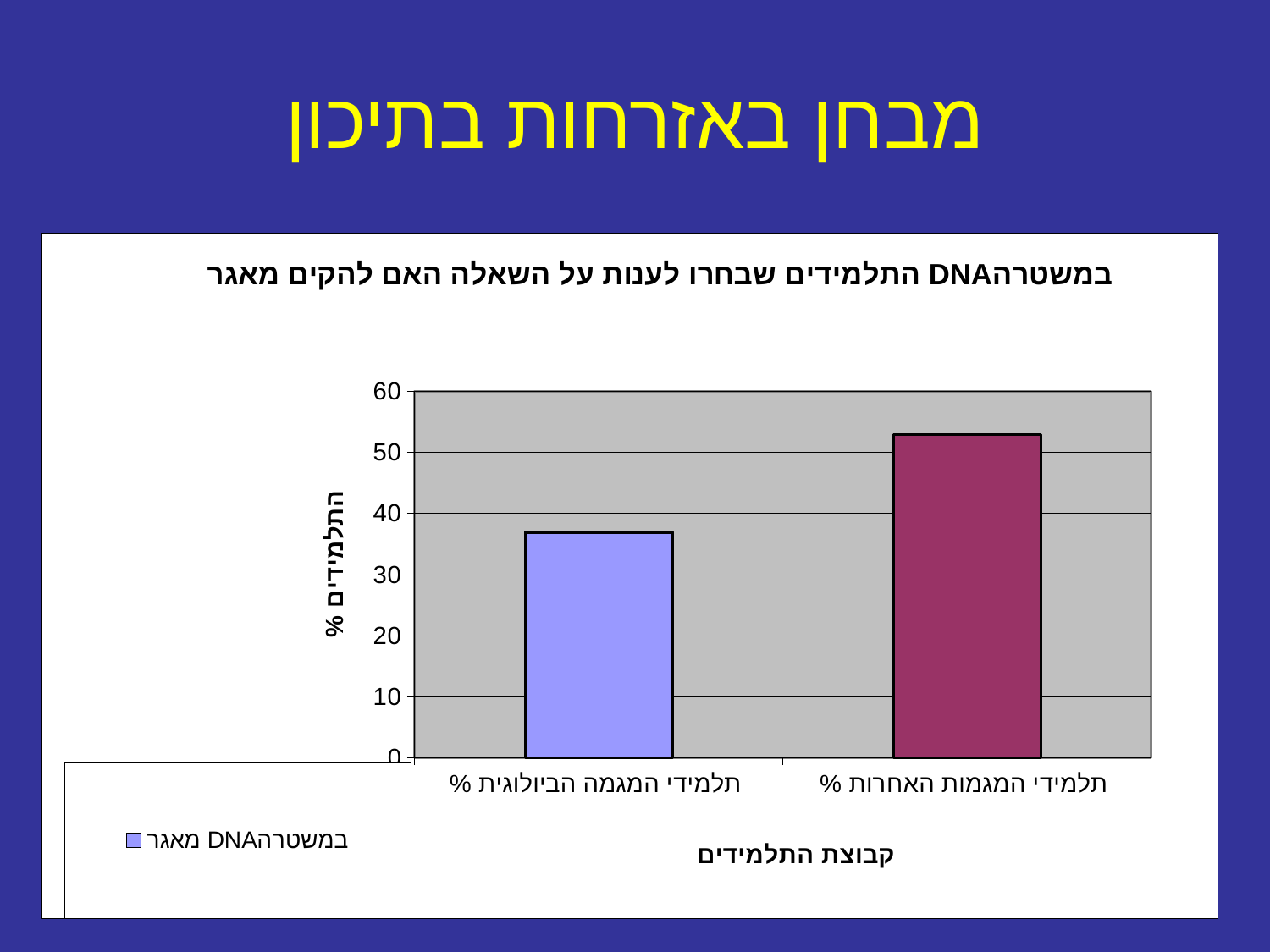
Is the value for תלמידי המגמות האחרות % greater or less than 50? greater How many series does the chart's legend list? 1 Is the value for תלמידי המגמה הביולוגית % greater or less than 30? greater Is the value for תלמידי המגמה הביולוגית % greater or less than 40? less What is the title of the chart's horizontal (x) axis? קבוצת התלמידים What kind of chart is shown on the slide? bar chart How many categories (bars) are plotted in the chart? 2 What is the label of the series shown in the chart's legend? מאגר DNA במשטרה Which is larger: the value for תלמידי המגמה הביולוגית % or the value for תלמידי המגמות האחרות %? תלמידי המגמות האחרות % Which category has the highest value in the chart? תלמידי המגמות האחרות % Which category has the lowest value in the chart? תלמידי המגמה הביולוגית %